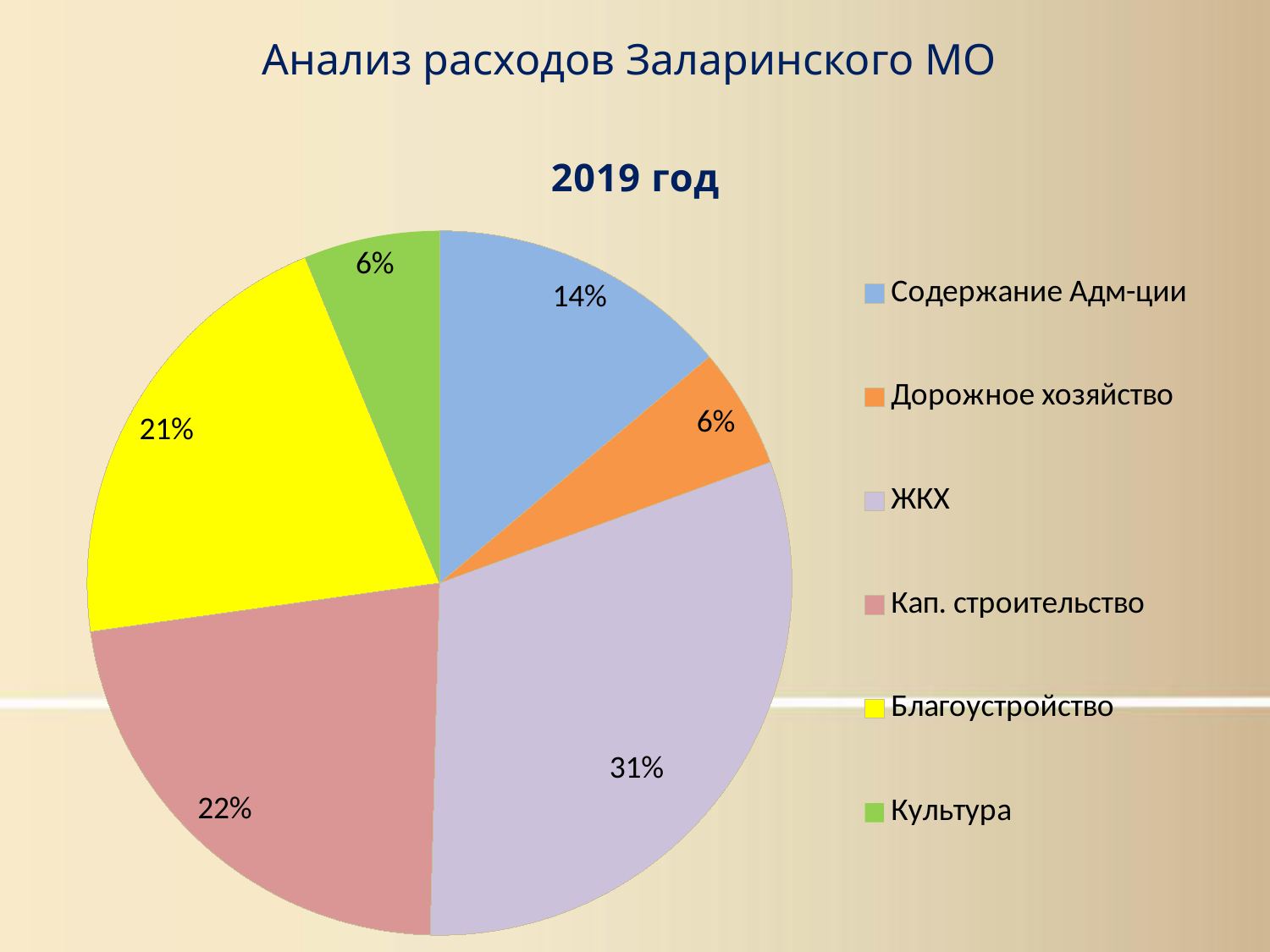
What share of the pie does ЖКХ take? 31% Which category has the largest slice of the pie? ЖКХ Which is larger, ЖКХ or Кап. строительство? ЖКХ Which colour represents Дорожное хозяйство in the legend? orange What is the title of the chart? 2019 год What is the value shown for Благоустройство? 21% What share of the pie does Культура take? 6% What is the difference between the shares of ЖКХ and Содержание Адм-ции? 17% What is the value shown for Кап. строительство? 22% What kind of chart is shown on the slide? pie chart How many categories does the pie chart have? 6 What is the value shown for Содержание Адм-ции? 14%